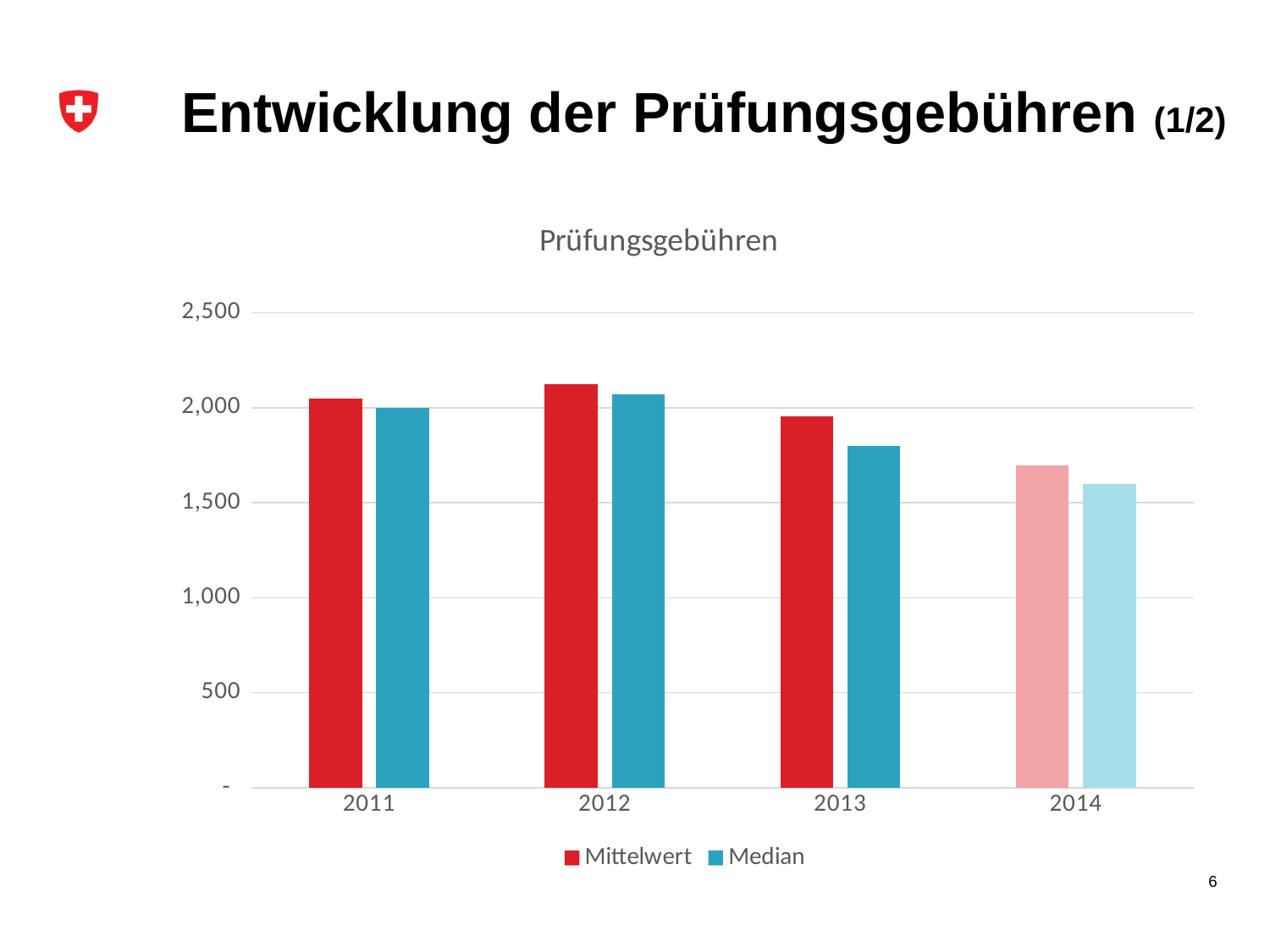
In which year is the Mittelwert value highest? 2012 What is the title of the chart? Prüfungsgebühren How many series does the chart legend list? 2 Do the Median values rise or fall from 2012 to 2014? fall Which is larger in 2013, the Mittelwert or the Median? Mittelwert Is the Median value for 2014 greater or less than 1,500? greater What kind of chart is shown on the slide? bar chart How many years are shown on the x axis of the chart? 4 In which year is the Median value lowest? 2014 Which two series are listed in the chart legend? Mittelwert and Median Is the Median value for 2013 greater or less than 2,000? less Is the Mittelwert value for 2012 greater or less than 2,000? greater